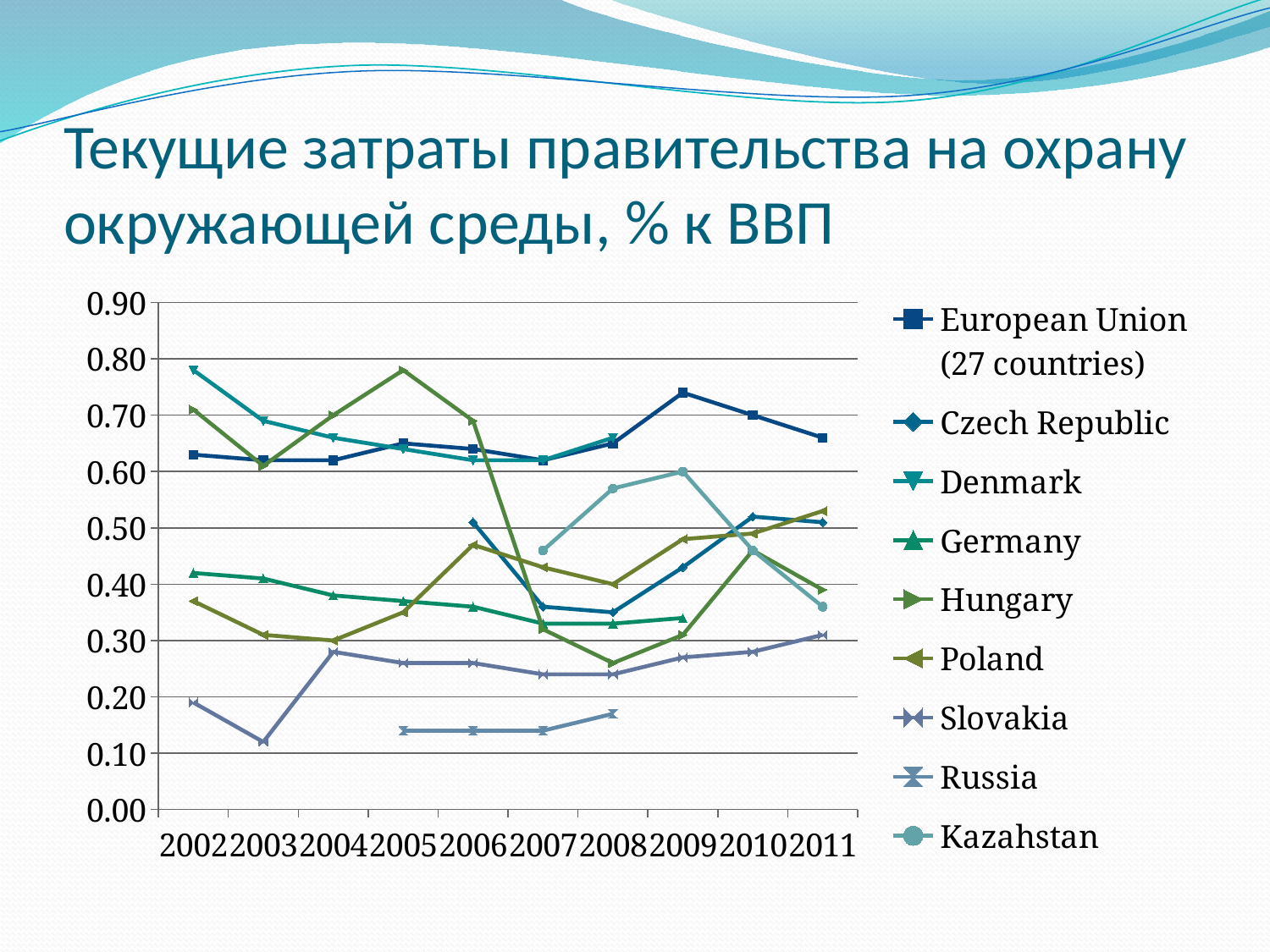
How many series does the legend list? 9 Which series has the highest value in 2002? Denmark What kind of chart is shown on the slide? line chart In 2009, which is larger: the value for European Union (27 countries) or the value for Kazahstan? European Union (27 countries) Is the value for Russia in 2008 greater or less than 0.20? less Does the value for Germany rise or fall from 2002 to 2007? fall Which series has the lowest value in 2003? Slovakia Is the value for Denmark in 2002 greater or less than 0.70? greater Is the value for Slovakia in 2003 greater or less than 0.20? less How many years are shown along the x axis? 10 Which series has the lowest value in 2007? Russia